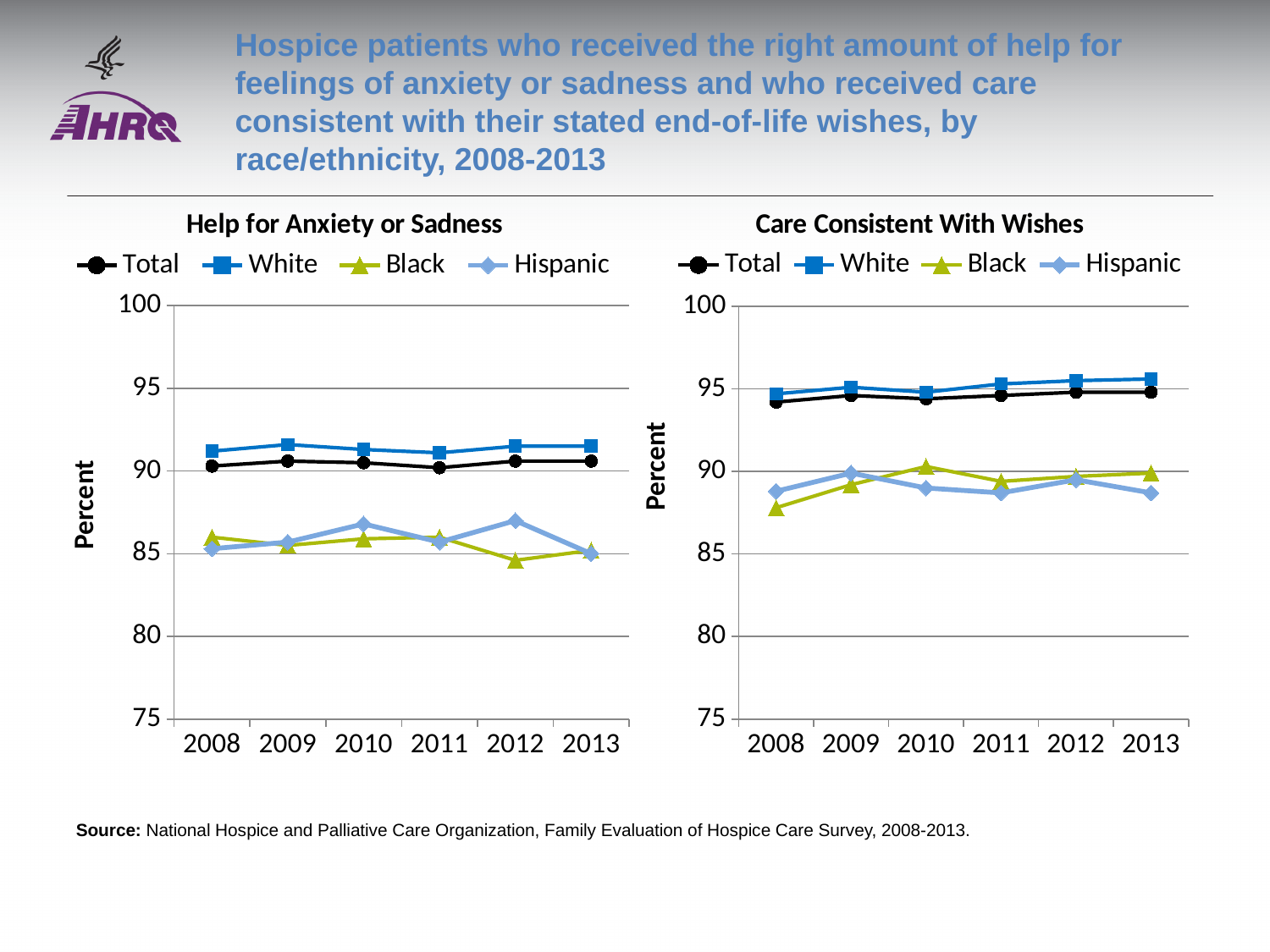
In the 'Care Consistent With Wishes' chart, is the value for Total in 2010 greater or less than 90? greater In the 'Help for Anxiety or Sadness' chart, which is larger in 2013, White or Black? White In the 'Help for Anxiety or Sadness' chart, is the value for Black in 2012 greater or less than 85? less In the 'Help for Anxiety or Sadness' chart, is the value for White in 2008 greater or less than 90? greater In the 'Care Consistent With Wishes' chart, does the White series rise or fall from 2008 to 2013? rises How many years are shown on the x axis of the 'Help for Anxiety or Sadness' chart? 6 How many series does the legend of the 'Care Consistent With Wishes' chart list? 4 What kind of chart is the 'Help for Anxiety or Sadness' chart? line chart In the 'Care Consistent With Wishes' chart, which group has the highest value in 2013? White What is the y-axis label on the 'Help for Anxiety or Sadness' chart? Percent In the 'Care Consistent With Wishes' chart, which group has the lowest value in 2008? Black